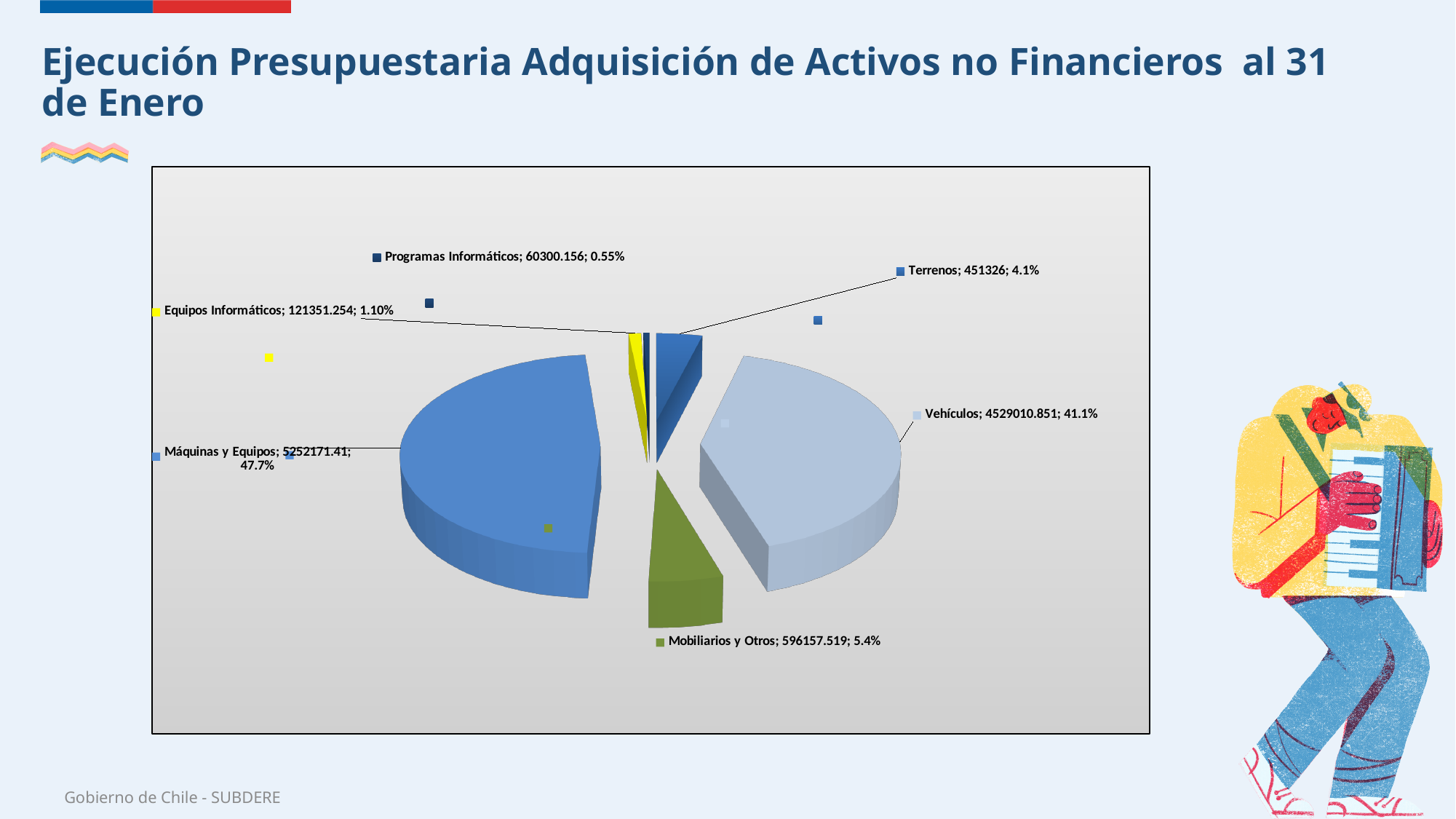
How many slices does the pie chart have? 6 What percentage share does Programas Informáticos have? 0.55% What is the value shown for Vehículos? 4529010.851 Which category has the largest slice of the pie? Máquinas y Equipos Which is larger, the value for Mobiliarios y Otros or the value for Terrenos? Mobiliarios y Otros What is the difference in percentage share between Máquinas y Equipos and Vehículos? 6.6% What kind of chart is shown on the slide? pie chart What percentage share does Máquinas y Equipos have? 47.7% What is the value shown for Equipos Informáticos? 121351.254 What is the title of the slide containing the chart? Ejecución Presupuestaria Adquisición de Activos no Financieros al 31 de Enero What is the value shown for Terrenos? 451326 Which category has the smallest slice of the pie? Programas Informáticos